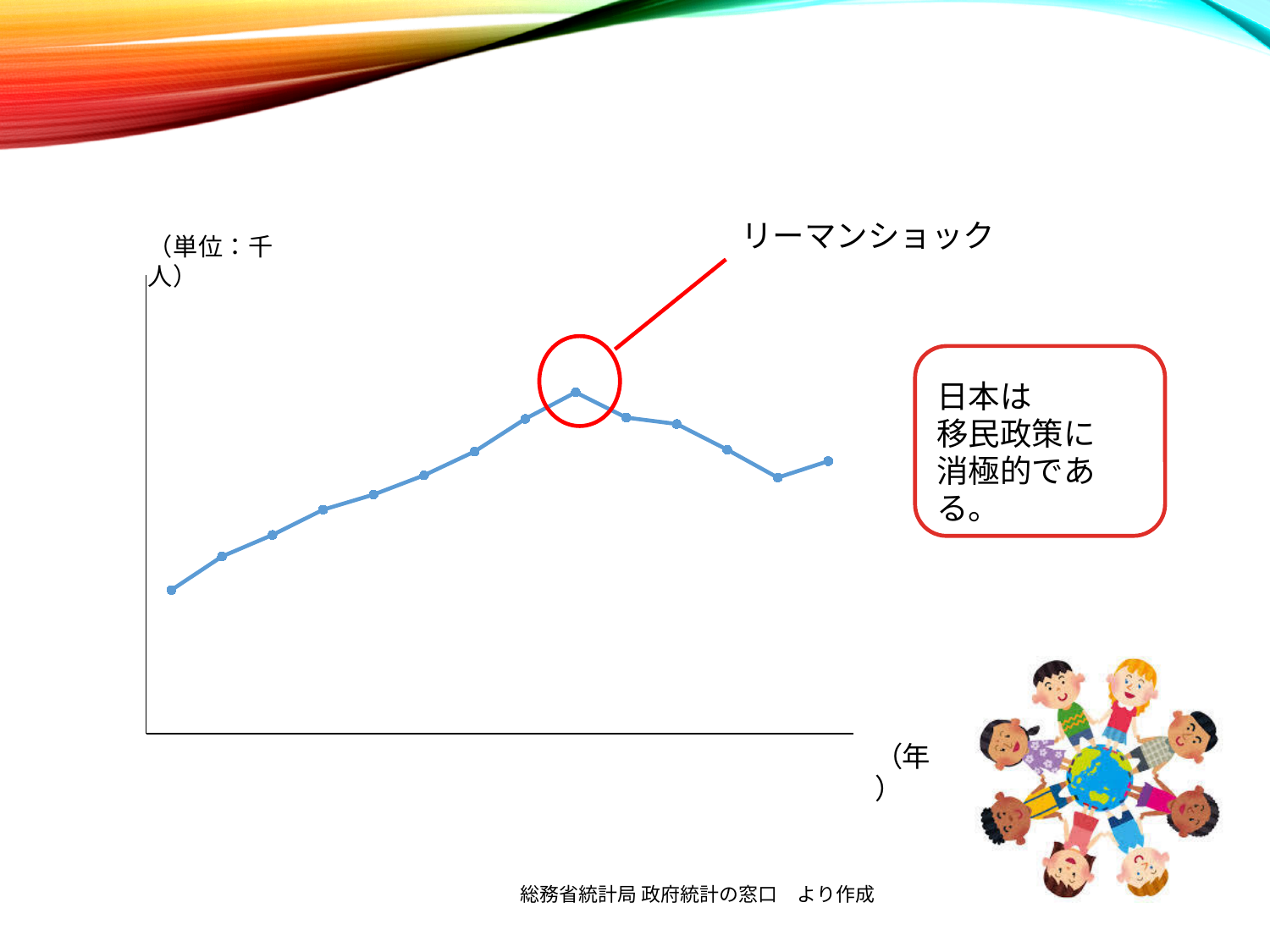
How many data points are plotted on the line? 14 Is the second-to-last point higher or lower than the last point? lower What unit is stated for the vertical axis of the chart? 千人 What text is written next to the red circle pointing at the peak of the line? リーマンショック Over the four points immediately after the circled peak, do the values rise or fall? fall From the leftmost point up to the circled peak, do the values rise or fall? rise Is the rightmost point higher or lower than the leftmost point? higher How many lines are plotted on the chart? 1 Which point on the line is the lowest? the leftmost point Is the rightmost point higher or lower than the circled peak? lower Which point on the line is the highest? the point circled in red (リーマンショック) What kind of chart is shown on the slide? line chart